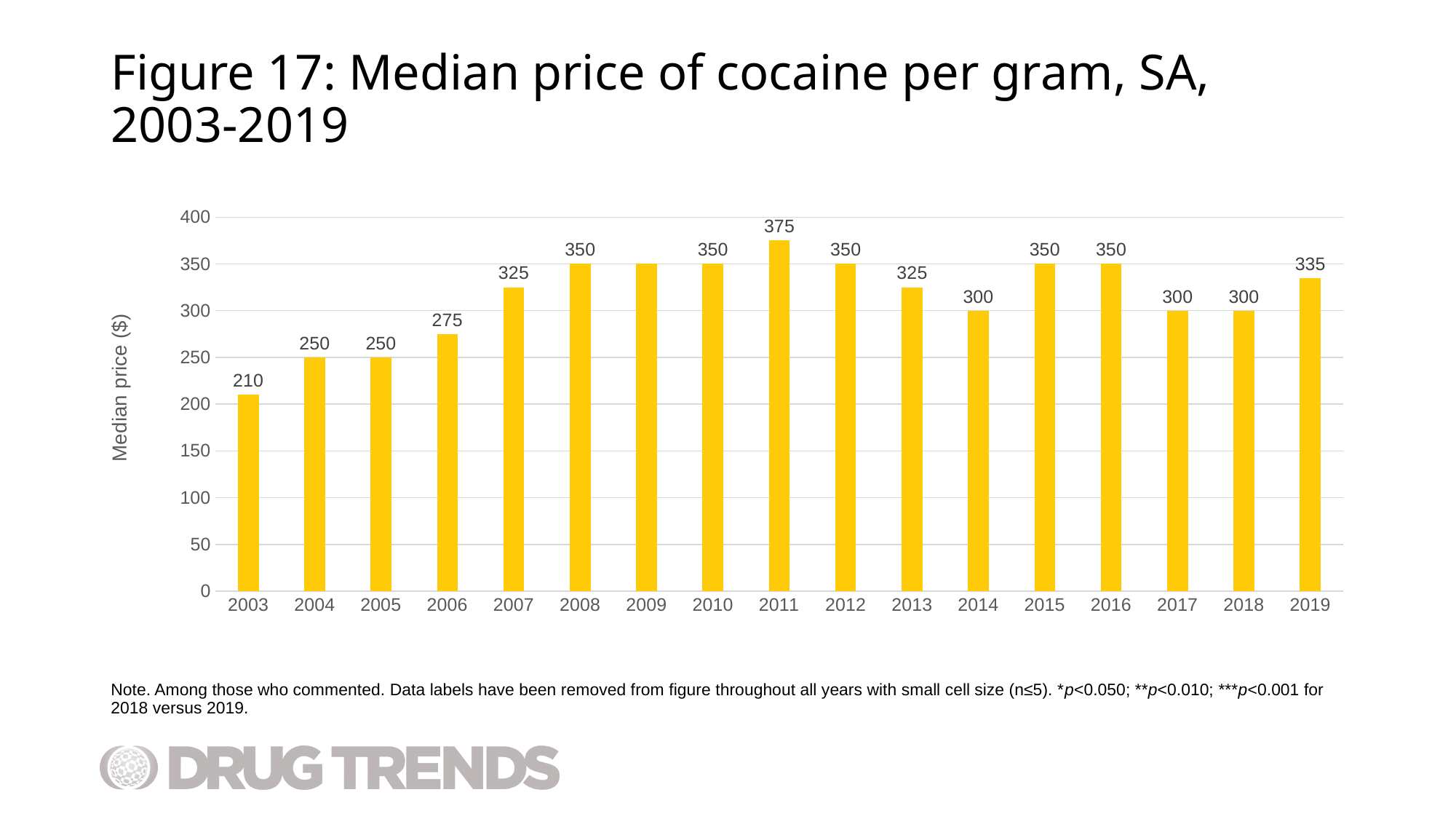
What was the median price of cocaine per gram in SA in 2003? 210 What was the median price of cocaine per gram in SA in 2011? 375 What is the difference between the median price in 2011 and the median price in 2003? 165 What was the median price of cocaine per gram in SA in 2019? 335 How many years are shown on the x axis of the chart? 17 Which year has the lowest median price of cocaine per gram? 2003 Which year had a higher median price of cocaine per gram, 2007 or 2014? 2007 What is the label of the vertical axis? Median price ($) What kind of chart is shown on the slide? Bar chart What was the median price of cocaine per gram in SA in 2006? 275 Is the value for 2009 greater or less than 300? greater Which year has the highest median price of cocaine per gram? 2011